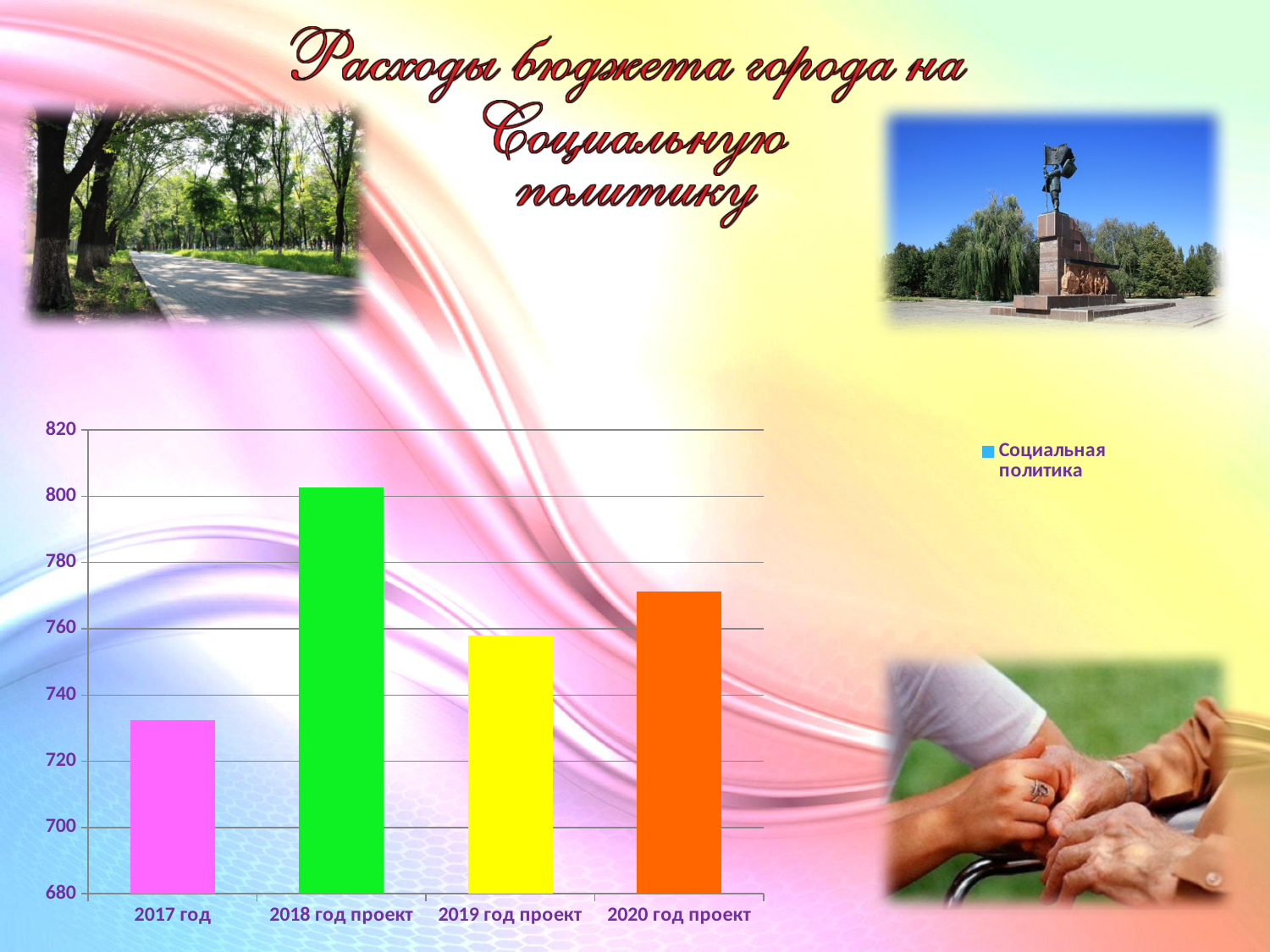
How many series does the chart legend list? 1 Is the value for 2018 год проект greater or less than 780? greater Is the value for 2020 год проект greater or less than 760? greater What series name is shown in the chart legend? Социальная политика Is the value for 2017 год greater or less than 740? less What kind of chart is shown on the slide? bar chart Which year has the lowest bar in the chart? 2017 год How many categories (years) are shown on the x axis of the chart? 4 Does the value rise or fall from 2017 год to 2018 год проект? rise Which year has the highest bar in the chart? 2018 год проект Which is larger: the value for 2020 год проект or the value for 2019 год проект? 2020 год проект